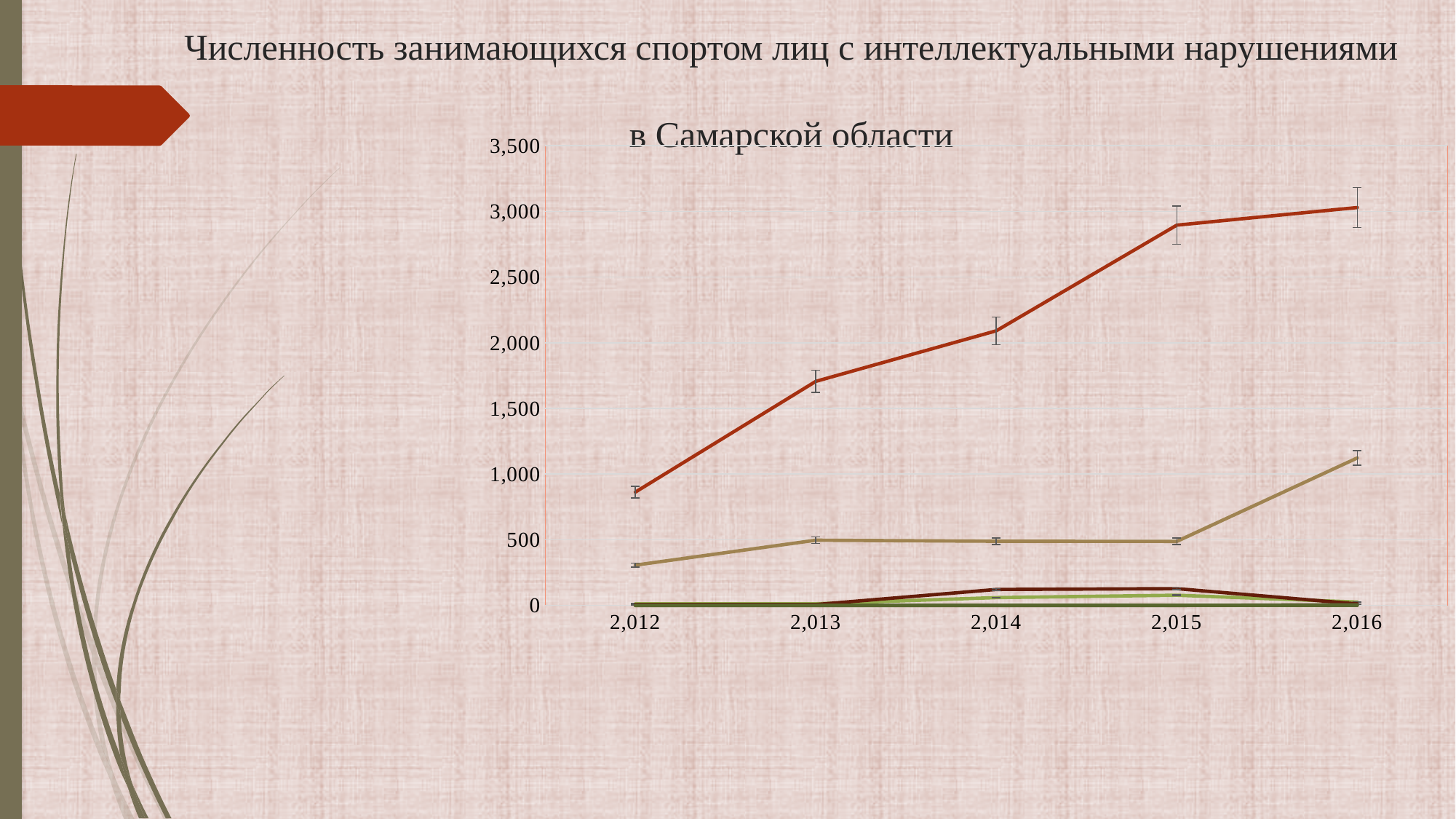
Is the value of the top (red) line in 2,013 greater or less than 1,500? greater Does the top (red) line rise or fall from 2,012 to 2,016? rise What kind of chart is shown on the slide? line chart Is the value of the top (red) line in 2,012 greater or less than 1,000? less Is the value of the top (red) line in 2,015 greater or less than 2,500? greater What is the first year shown on the x axis? 2,012 In 2,016, which line has the larger value, the red line or the tan line? the red line In which year does the top (red) line have its lowest value? 2,012 What is the highest value shown on the y axis of the chart? 3,500 In which year does the top (red) line reach its highest value? 2,016 How many years are shown along the x axis of the chart? 5